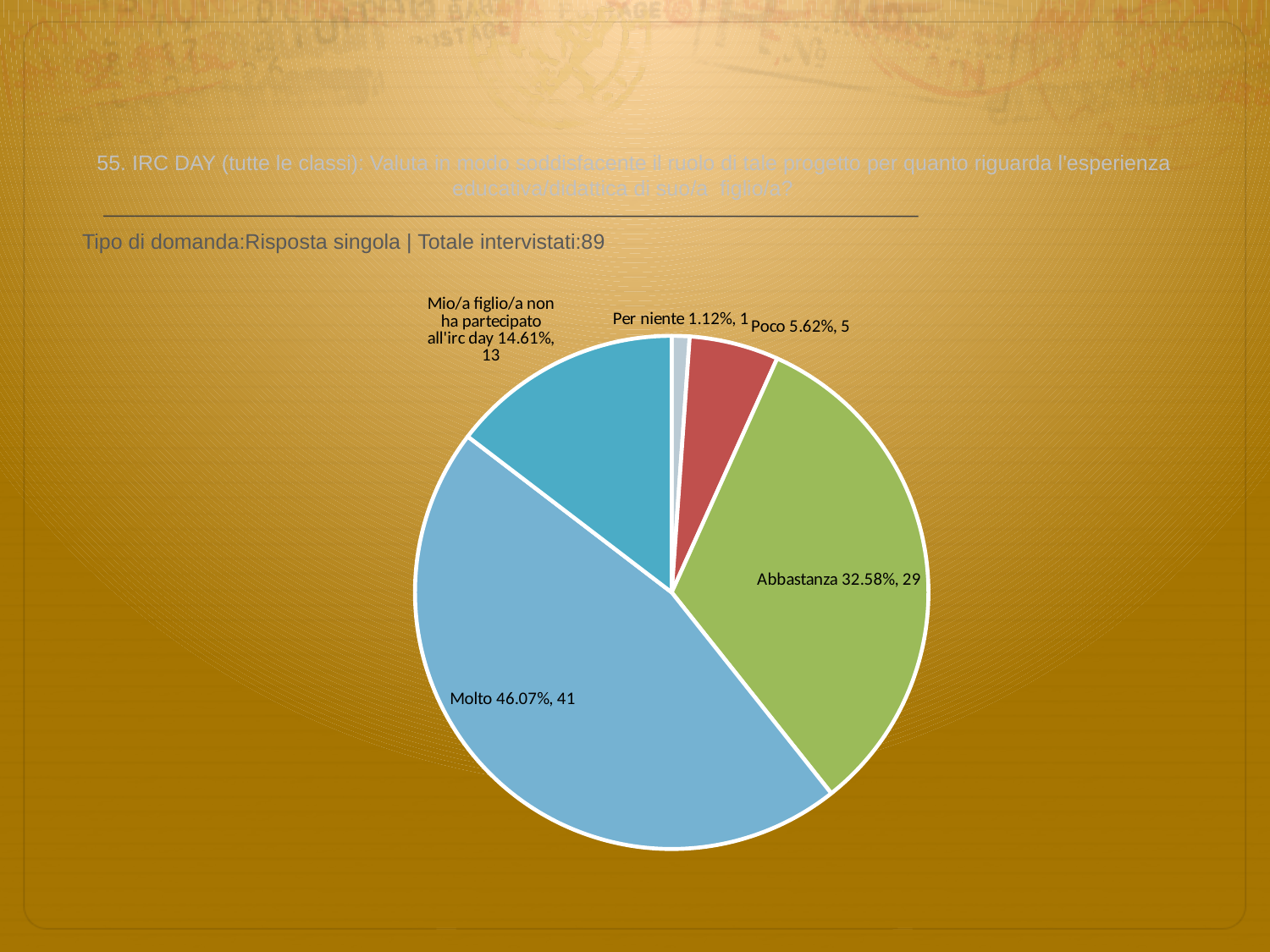
Which category has the smallest slice? Per niente What colour is the 'Abbastanza' slice? green What is the difference in count between 'Molto' and 'Abbastanza'? 12 What is the total number of respondents (Totale intervistati) stated on the slide? 89 Which is larger, the 'Poco' slice or the 'Mio/a figlio/a non ha partecipato all'irc day' slice? Mio/a figlio/a non ha partecipato all'irc day What is the count for the 'Molto' slice? 41 What is the count for the 'Poco' slice? 5 What kind of chart is shown on the slide? pie chart Which category has the largest slice? Molto What percentage does the 'Mio/a figlio/a non ha partecipato all'irc day' slice represent? 14.61% How many slices does the pie chart have? 5 What percentage does the 'Abbastanza' slice represent? 32.58%